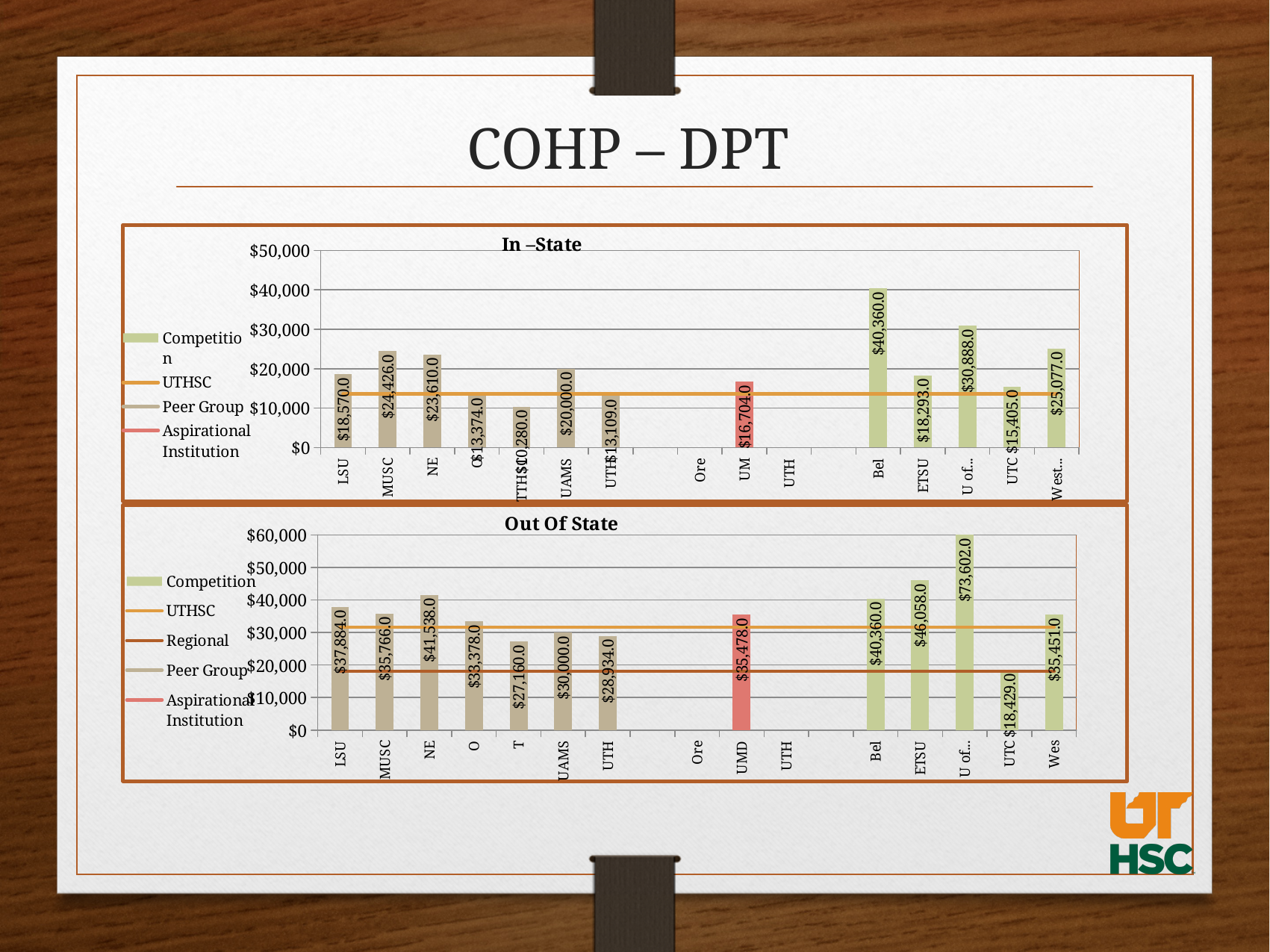
In the In –State chart, what is the difference between the values for MUSC and NE? $816.0 In the Out Of State chart, which labelled bar has the highest value? U of... In the In –State chart, which labelled bar has the highest value? Bel In the Out Of State chart, how many entries does the legend list? 5 In the Out Of State chart, which labelled bar has the lowest value? UTC In the In –State chart, what is the value for Bel? $40,360.0 In the In –State chart, which is larger, the value for UAMS or the value for ETSU? UAMS In the Out Of State chart, what is the value for ETSU? $46,058.0 In the Out Of State chart, what is the difference between the values for NE and LSU? $3,654.0 In the In –State chart, how many entries does the legend list? 4 What type of chart is the Out Of State chart? Bar chart In the In –State chart, what is the value for MUSC? $24,426.0